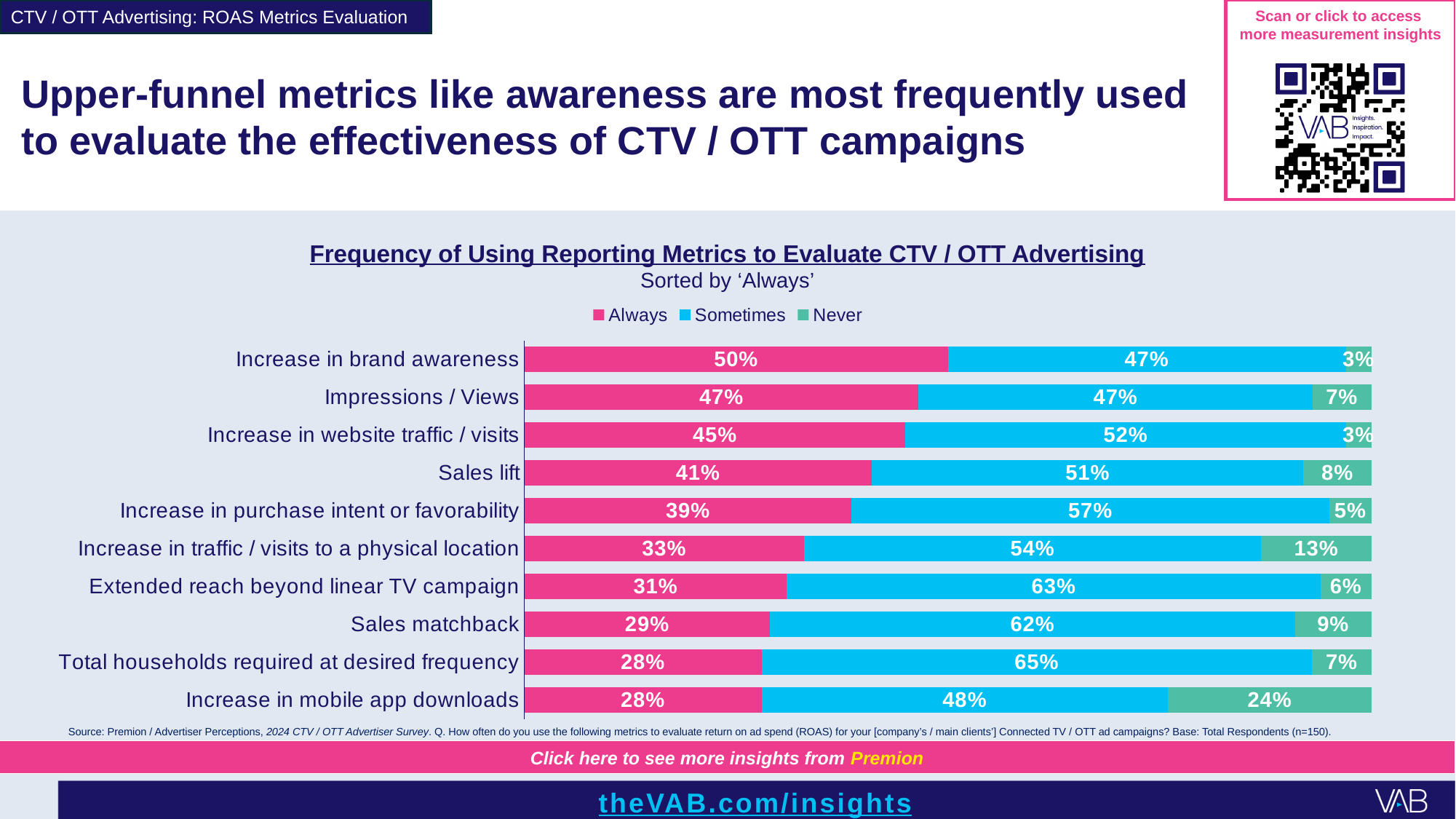
Which metric has the highest 'Sometimes' percentage? Total households required at desired frequency What type of chart is shown on the slide? Stacked bar chart What is the 'Sometimes' value for Extended reach beyond linear TV campaign? 63% Which has a larger 'Always' percentage: Sales matchback or Increase in website traffic / visits? Increase in website traffic / visits Which metric has the highest 'Always' percentage? Increase in brand awareness What is the difference between the 'Always' percentages for Increase in brand awareness and Sales lift? 9% What is the title of the chart? Frequency of Using Reporting Metrics to Evaluate CTV / OTT Advertising What percentage of respondents 'Always' use increase in brand awareness to evaluate CTV / OTT advertising? 50% How many series does the legend list? 3 What is the 'Never' value for Increase in mobile app downloads? 24% How many metrics are listed in the chart? 10 Which metric has the highest 'Never' percentage? Increase in mobile app downloads